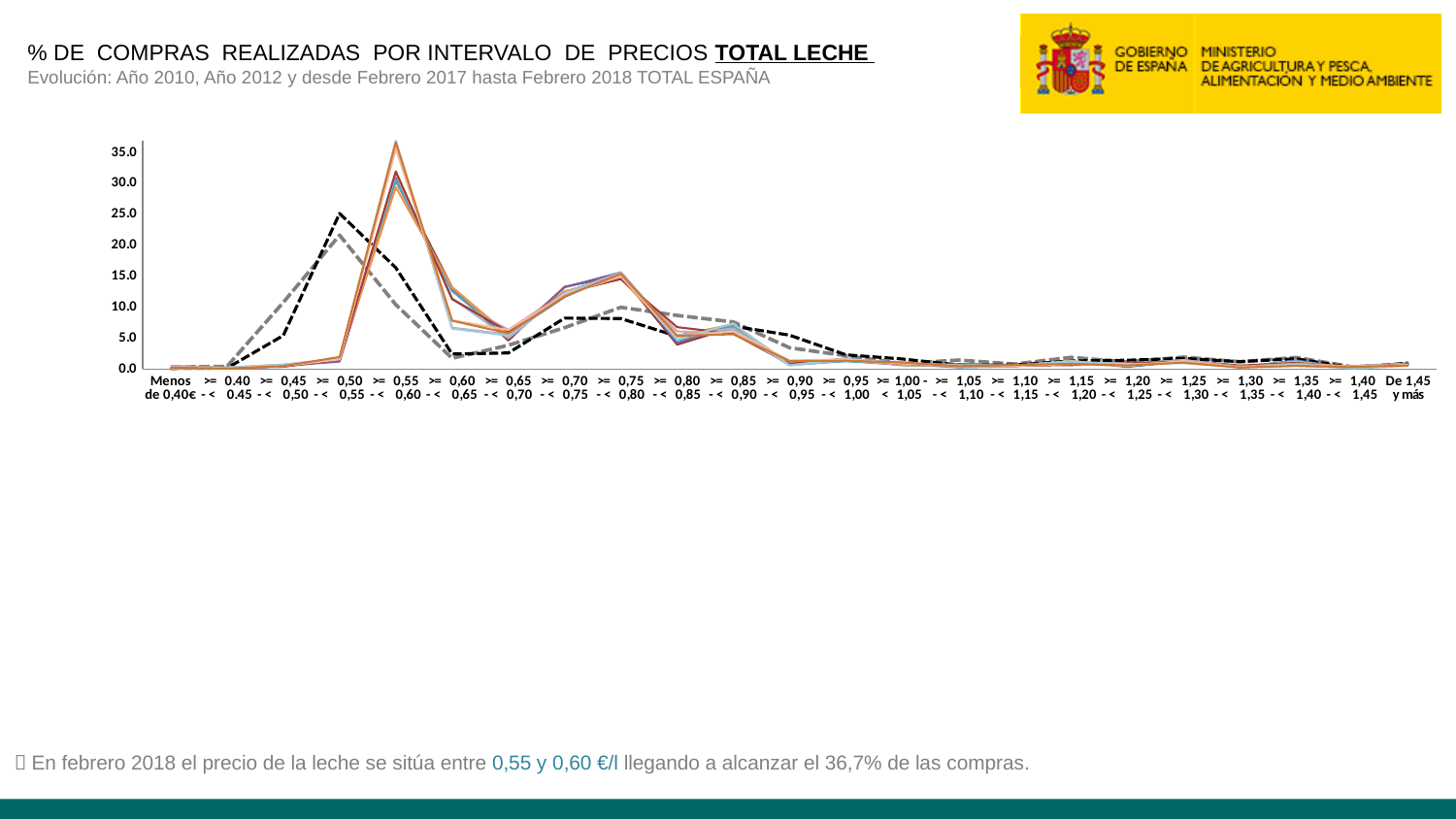
Is the peak value of the solid lines at the 0,55 - 0,60 interval greater or less than 30? greater How many price intervals are shown along the x axis of the chart? 23 For the solid lines, which interval has the larger value: 0,55 - 0,60 or 0,75 - 0,80? 0,55 - 0,60 Are the values of the solid lines at the 0,65 - 0,70 interval greater or less than 10? less What kind of chart is shown on the slide? line chart In which price interval do the solid lines reach their highest value? >= 0,55 - < 0,60 What is the label of the first category on the x axis of the chart? Menos de 0,40€ What is the highest tick value shown on the y axis of the chart? 35.0 Are the values of the solid lines at the 0,75 - 0,80 interval greater or less than 10? greater Do the solid lines rise or fall between the 0,55 - 0,60 interval and the 0,65 - 0,70 interval? fall